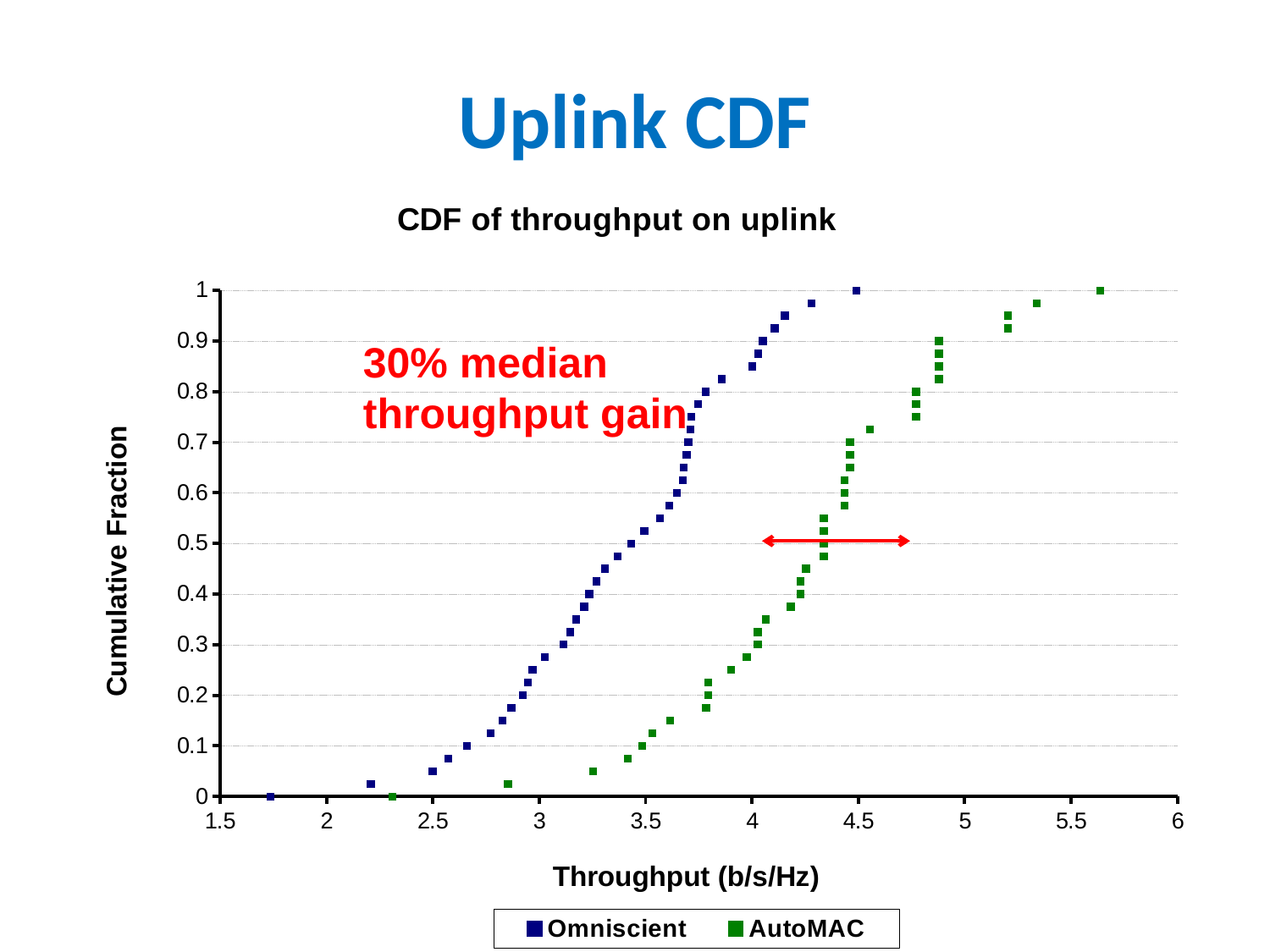
How many series does the legend list? 2 What is the title of the chart? CDF of throughput on uplink Which series reaches a cumulative fraction of 1 at the higher throughput, Omniscient or AutoMAC? AutoMAC Which series has the lower throughput at a cumulative fraction of 0.5, Omniscient or AutoMAC? Omniscient Is the throughput of the lowest Omniscient point greater or less than 2? less What kind of chart is shown on the slide? scatter chart Is the throughput at which the AutoMAC series reaches a cumulative fraction of 1 greater or less than 5.5? greater What is the label of the x axis? Throughput (b/s/Hz) Is the throughput at which the Omniscient series reaches a cumulative fraction of 1 greater or less than 5? less Do the cumulative fraction values for the Omniscient series rise or fall as throughput increases along the x axis? rise